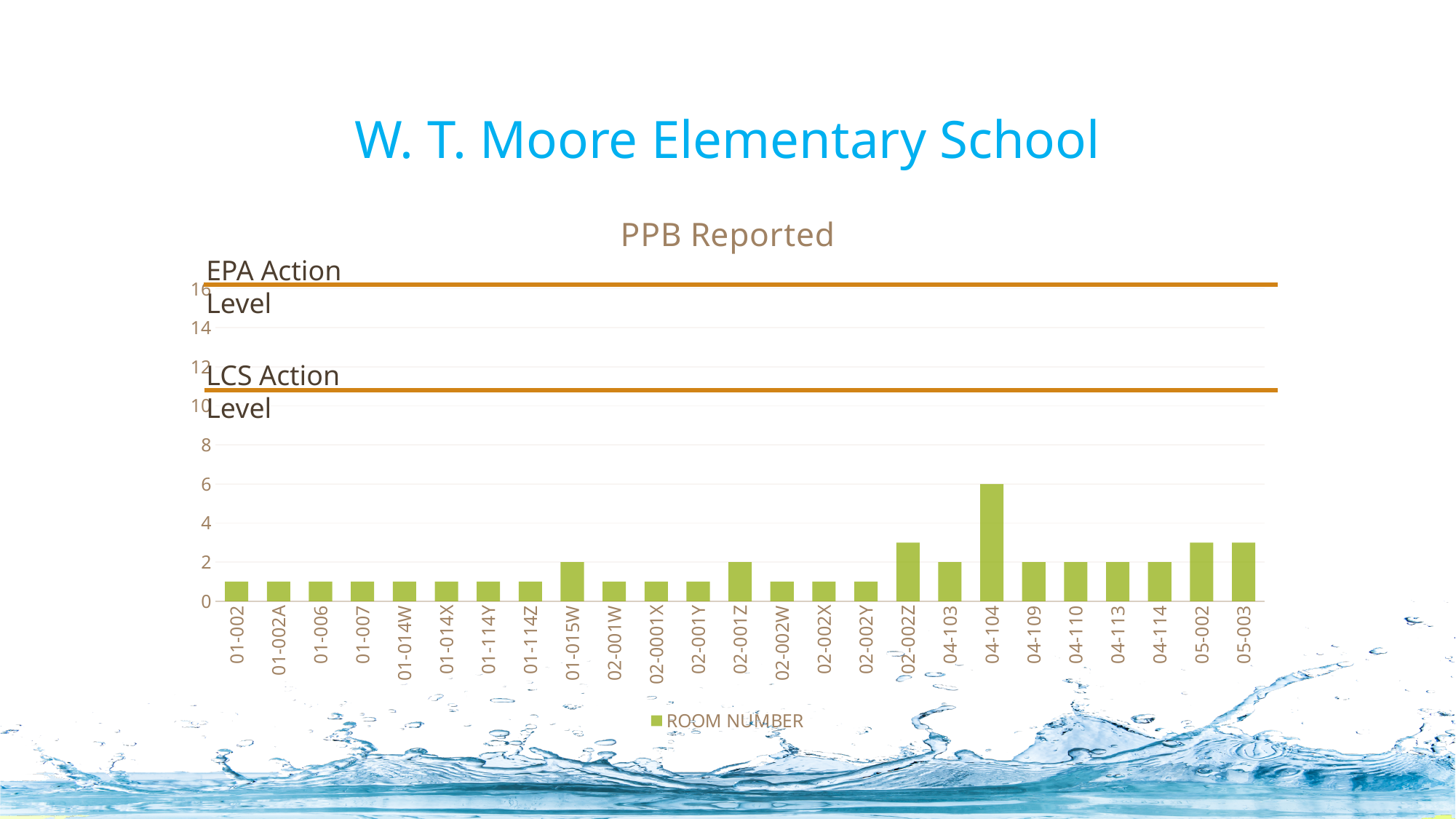
Which room number has the highest PPB reported value? 04-104 Is the value for room 05-003 greater or less than 2? greater What are the two horizontal reference lines on the chart labelled? EPA Action Level and LCS Action Level How many room numbers are plotted on the x axis? 25 What type of chart is shown on the slide? bar chart What is the title of the chart? PPB Reported Is the value for room 01-002 greater or less than 2? less What is the PPB reported value for room 01-015W? 2 Which has a larger value, room 04-104 or room 05-002? 04-104 How many series does the legend list? 1 What is the difference between the values for rooms 04-104 and 04-109? 4 What is the PPB reported value for room 04-104? 6